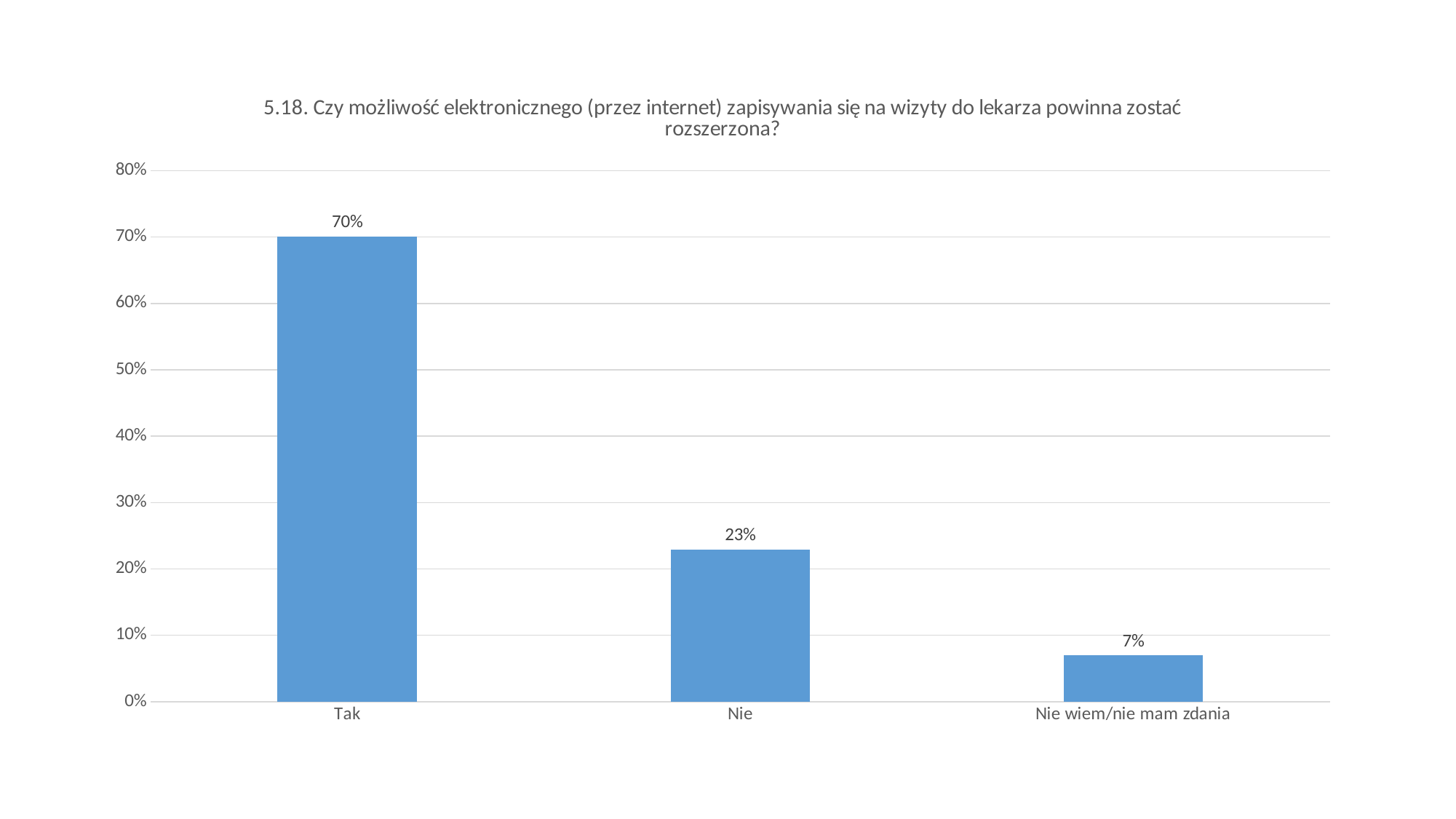
What is the value for "Nie"? 23% Do the values rise or fall from left to right along the x axis? fall What is the value for "Nie wiem/nie mam zdania"? 7% What is the difference between the values for "Tak" and "Nie"? 47% What kind of chart is shown on the slide? bar chart Which is larger, the value for "Nie" or the value for "Nie wiem/nie mam zdania"? Nie How many categories are shown on the x axis? 3 Is the value for "Nie" greater or less than 30%? less What is the value for "Tak"? 70% What is the difference between the values for "Nie" and "Nie wiem/nie mam zdania"? 16% Which category has the lowest value? Nie wiem/nie mam zdania Which category has the highest value? Tak